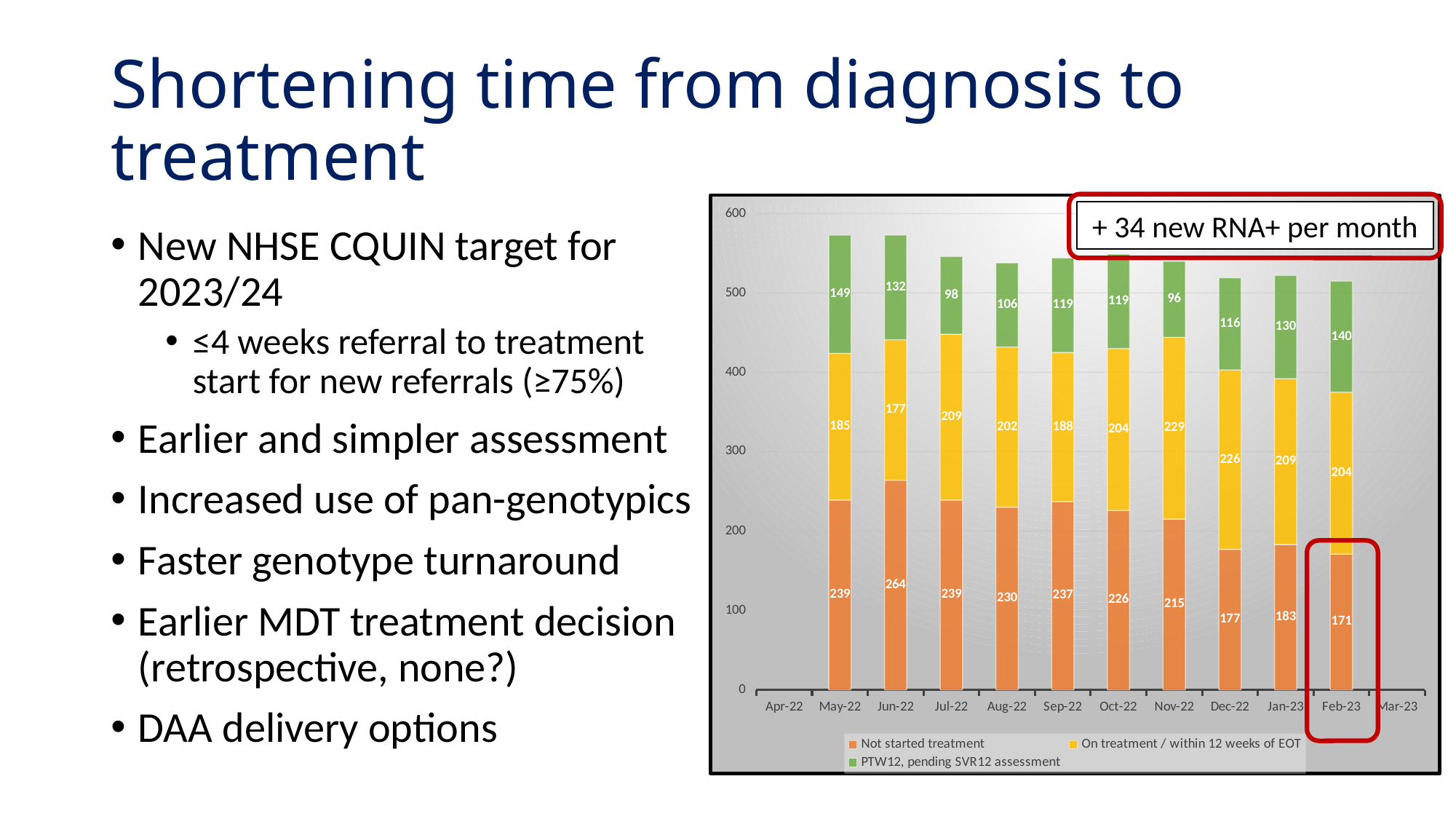
What is the difference between the 'Not started treatment' values for May-22 and Feb-23? 68 What is the value for 'PTW12, pending SVR12 assessment' in Feb-23? 140 What is the value for 'On treatment / within 12 weeks of EOT' in Nov-22? 229 What is the total of the stacked bar for Feb-23? 515 What does the red-boxed annotation at the top of the chart say? + 34 new RNA+ per month Which month has the highest value for 'Not started treatment'? Jun-22 Which month has the lowest value for 'Not started treatment'? Feb-23 Which month has the lowest value for 'PTW12, pending SVR12 assessment'? Nov-22 Which is larger, the 'On treatment / within 12 weeks of EOT' value for Jul-22 or for Aug-22? Jul-22 What kind of chart is shown on the slide? Stacked bar chart How many series does the legend list? 3 What is the value for 'Not started treatment' in Jun-22? 264